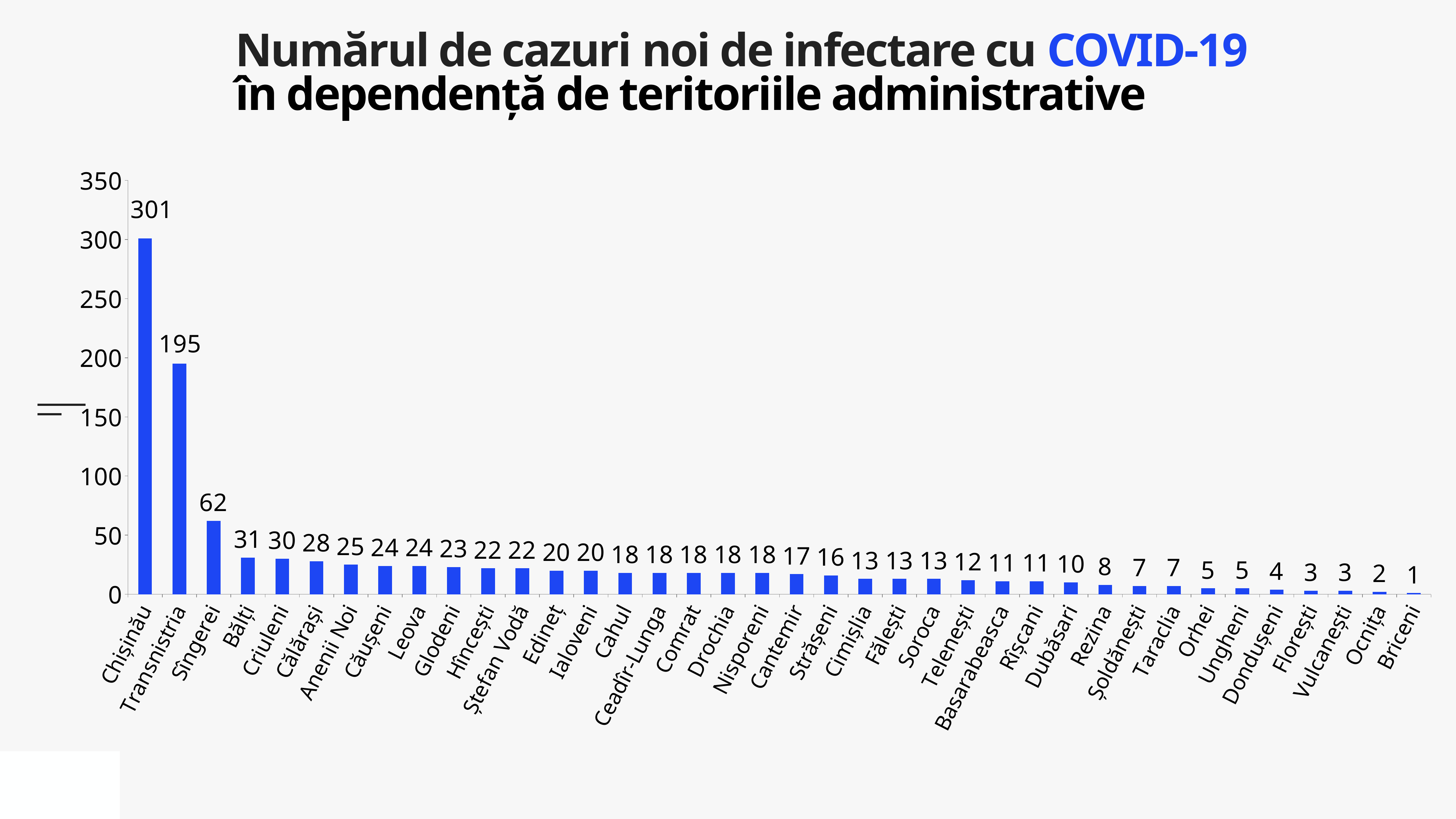
Do the values rise or fall from left to right along the x axis? fall Which territory has the highest number of new cases? Chișinău Which is larger, the value for Bălți or the value for Criuleni? Bălți What is the value for Cahul? 18 What is the difference between the values for Chișinău and Transnistria? 106 How many territories are shown on the x axis? 38 What is the value for Transnistria? 195 Is the value for Sîngerei greater or less than 50? greater What is the value for Sîngerei? 62 Which territory has the lowest number of new cases? Briceni What is the value for Chișinău? 301 What kind of chart is shown on the slide? bar chart